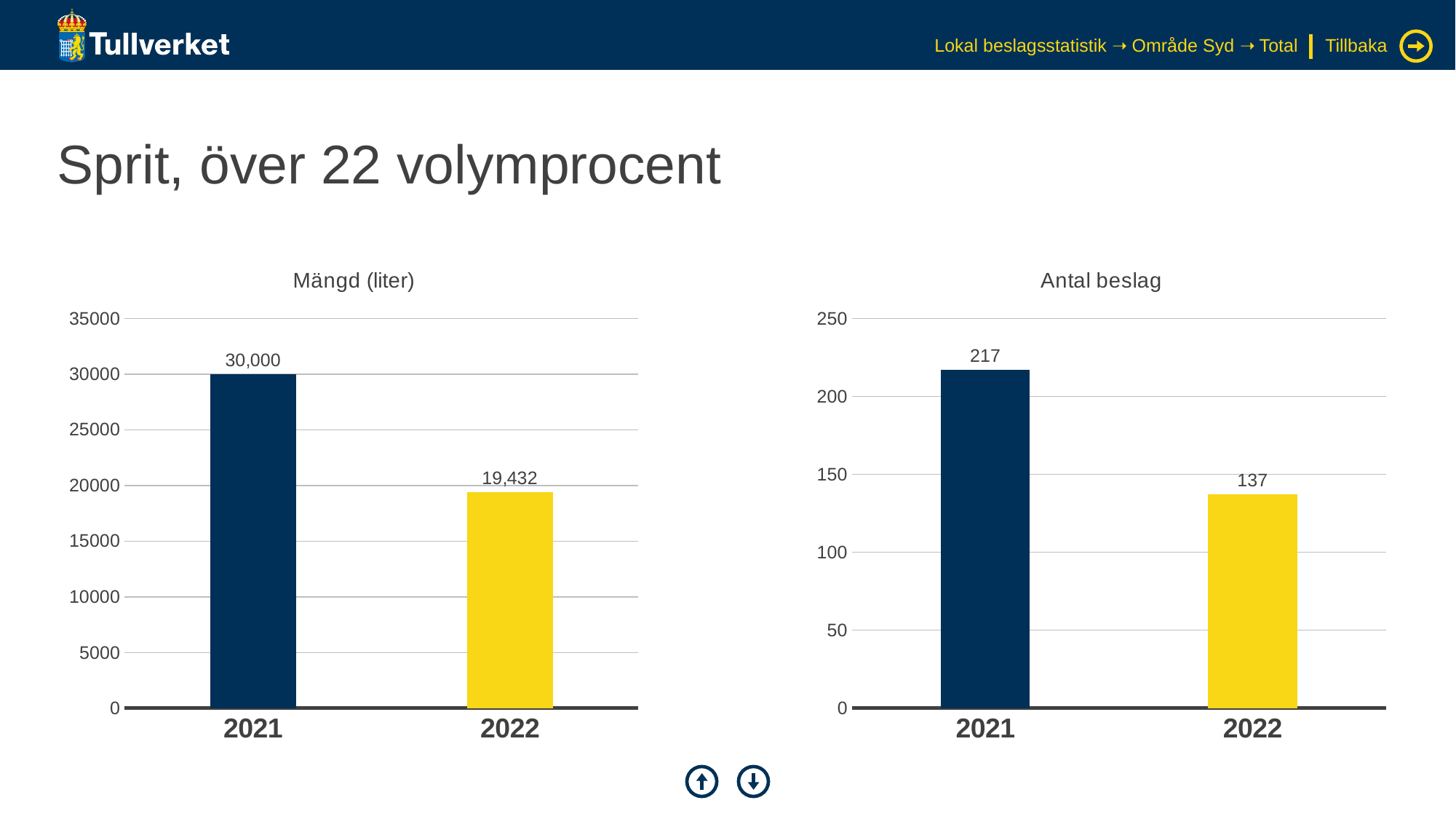
In the 'Antal beslag' chart, what is the difference between the 2021 and 2022 values? 80 In the 'Mängd (liter)' chart, what is the value for 2021? 30,000 In the 'Mängd (liter)' chart, which year has the highest value? 2021 In the 'Antal beslag' chart, is the value for 2021 greater or less than 200? greater In the 'Antal beslag' chart, what is the value for 2021? 217 In the 'Antal beslag' chart, what is the value for 2022? 137 In the 'Antal beslag' chart, which year has the lowest value? 2022 What kind of chart is the 'Antal beslag' chart? bar chart In the 'Mängd (liter)' chart, do the values rise or fall from 2021 to 2022? fall How many categories are shown on the x axis of the 'Mängd (liter)' chart? 2 In the 'Mängd (liter)' chart, what is the value for 2022? 19,432 In the 'Mängd (liter)' chart, what is the difference between the 2021 and 2022 values? 10,568